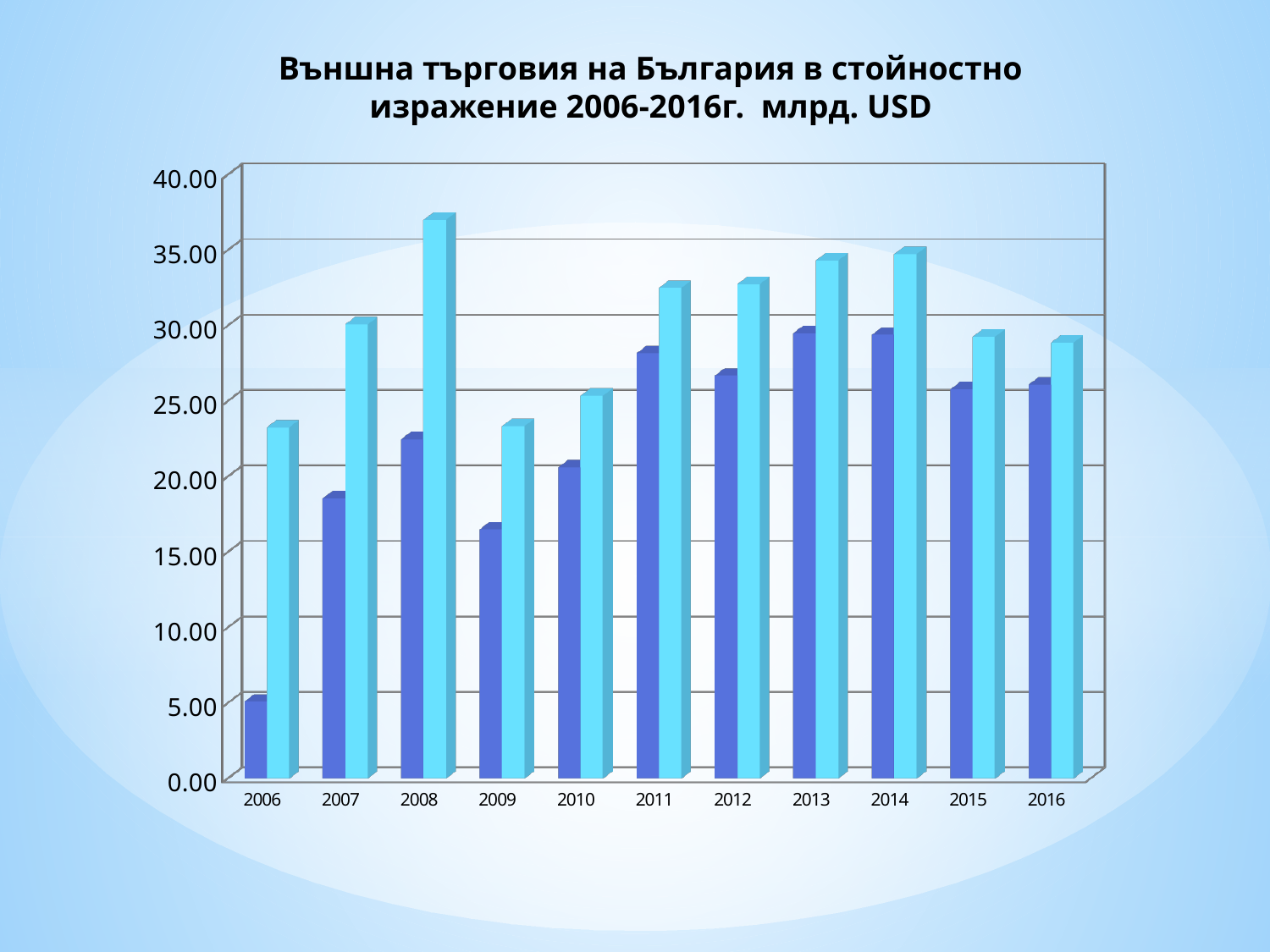
In which year is the dark blue bar the lowest? 2006 Is the value of the light blue bar for 2016 greater or less than 30.00? less How many years are shown on the x axis of the chart? 11 Which is larger, the light blue bar for 2008 or the light blue bar for 2009? 2008 Is the value of the dark blue bar for 2006 greater or less than 10.00? less Do the dark blue bars rise or fall from 2009 to 2011? rise In which year is the light blue bar the highest? 2008 Is the value of the light blue bar for 2008 greater or less than 35.00? greater What kind of chart is shown on the slide? bar chart In 2006, which bar is larger, the dark blue or the light blue? light blue What is the title of the chart? Външна търговия на България в стойностно изражение 2006-2016г. млрд. USD